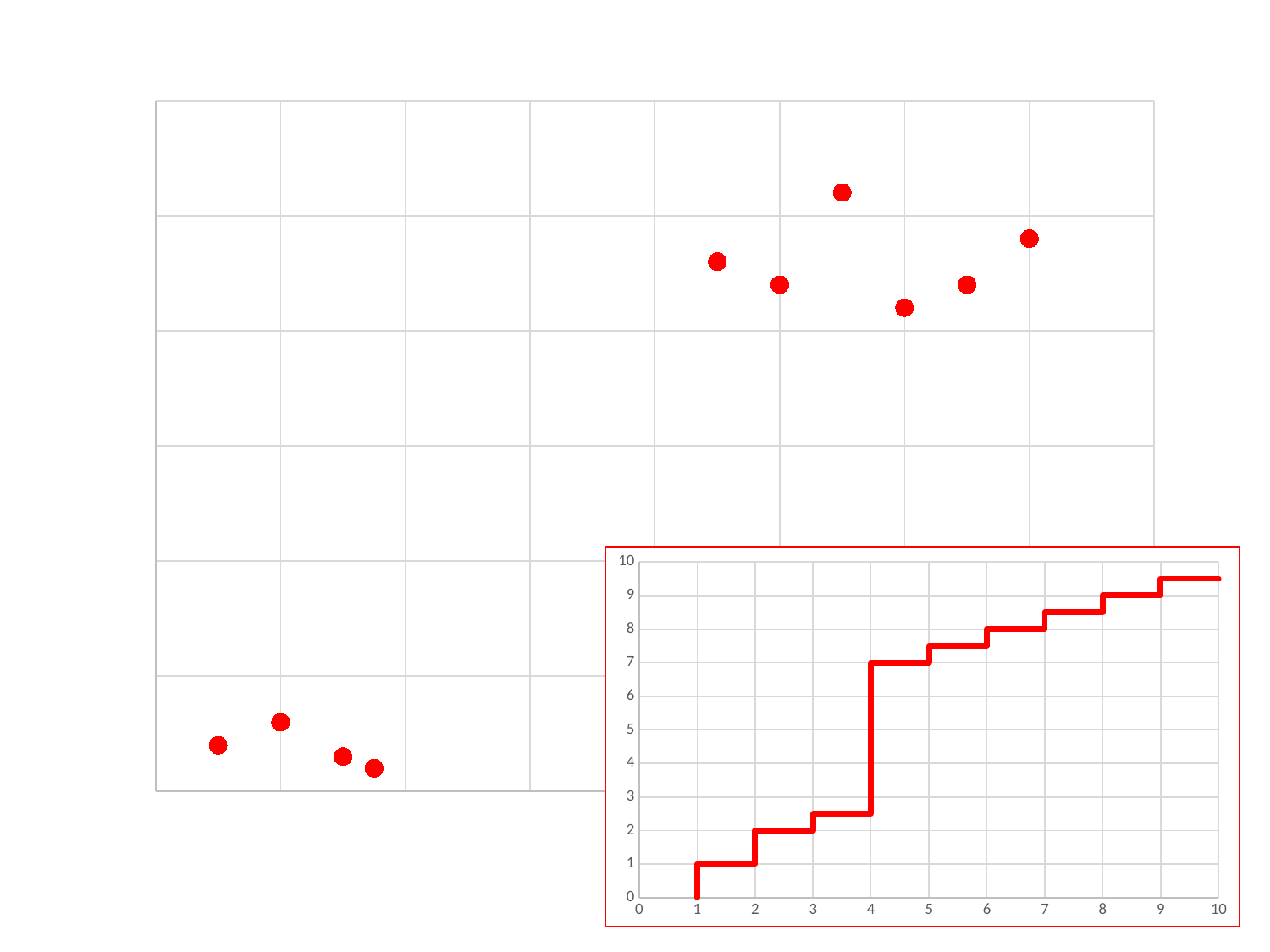
On the inset chart in the bottom right, is the y value of the line at x = 3.5 greater or less than 3? less On the inset chart in the bottom right, what is the y value of the line at x = 4.5? 7 On the inset chart in the bottom right, do the values rise or fall as x increases? rise On the inset chart in the bottom right, what is the y value of the line at x = 6.5? 8 On the inset chart in the bottom right, what is the y value of the line at x = 8.5? 9 On the inset chart in the bottom right, is the y value of the line at x = 9.5 greater or less than 9? greater On the inset chart in the bottom right, what colour is the plotted line? red How many data points are plotted on the large scatter chart on the left? 10 On the inset chart in the bottom right, what is the y value of the line at x = 2.5? 2 What kind of chart is the small inset chart in the bottom right of the slide? line chart On the inset chart in the bottom right, what is the highest value shown on the y axis? 10 What kind of chart is the large chart on the left of the slide? scatter chart